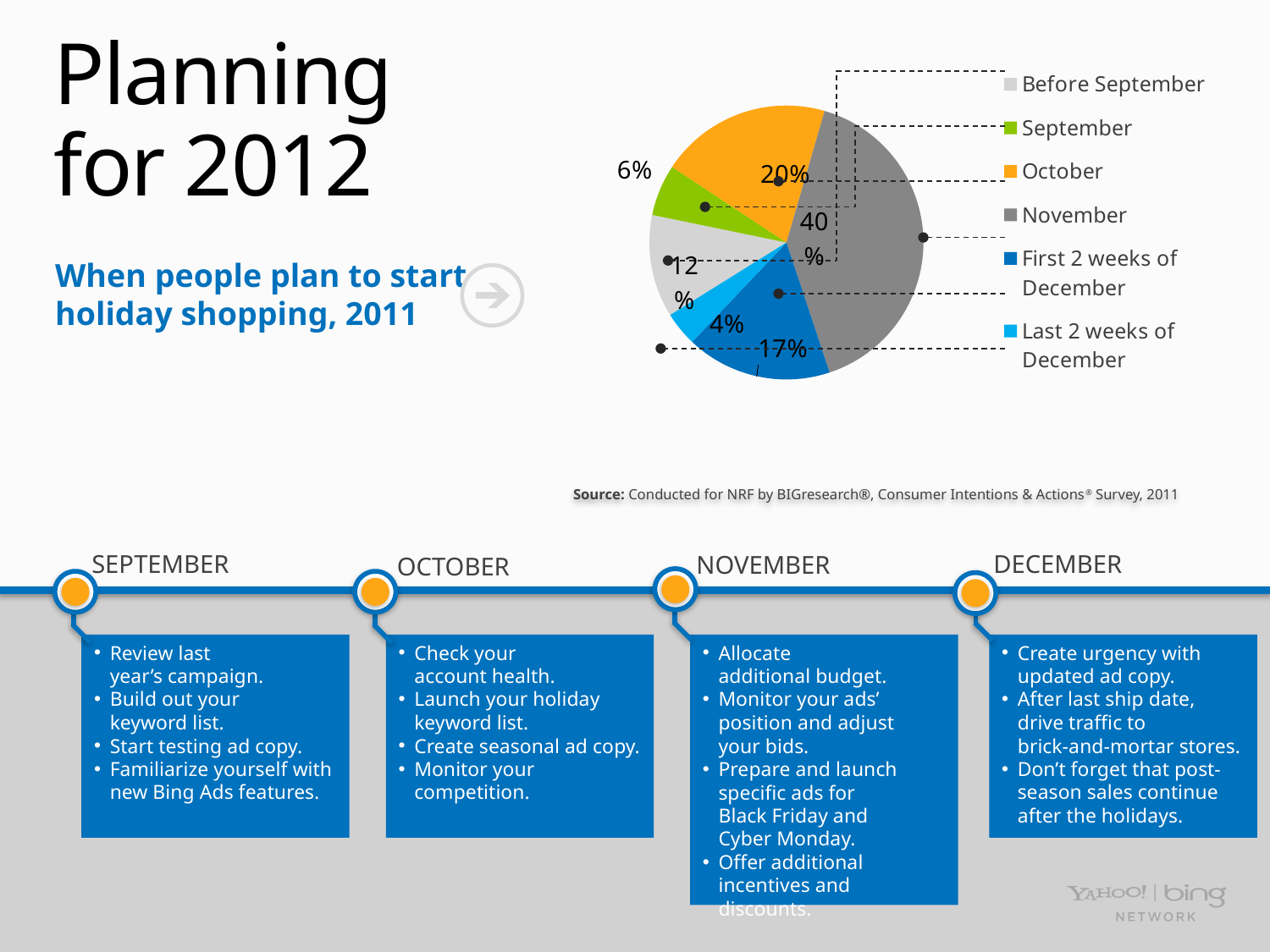
What colour is the slice for November? gray What kind of chart is shown on the slide? pie chart Which category has the smallest share of the pie? Last 2 weeks of December Which is larger: the share for September or the share for Before September? Before September What percentage of people plan to start holiday shopping in the first 2 weeks of December? 17% What percentage of people plan to start holiday shopping in November? 40% What is the difference in percentage points between November and October? 20 What percentage of people plan to start holiday shopping before September? 12% Which category has the largest share of the pie? November How many categories does the pie chart legend list? 6 What percentage of people plan to start holiday shopping in the last 2 weeks of December? 4% What percentage of people plan to start holiday shopping in October? 20%